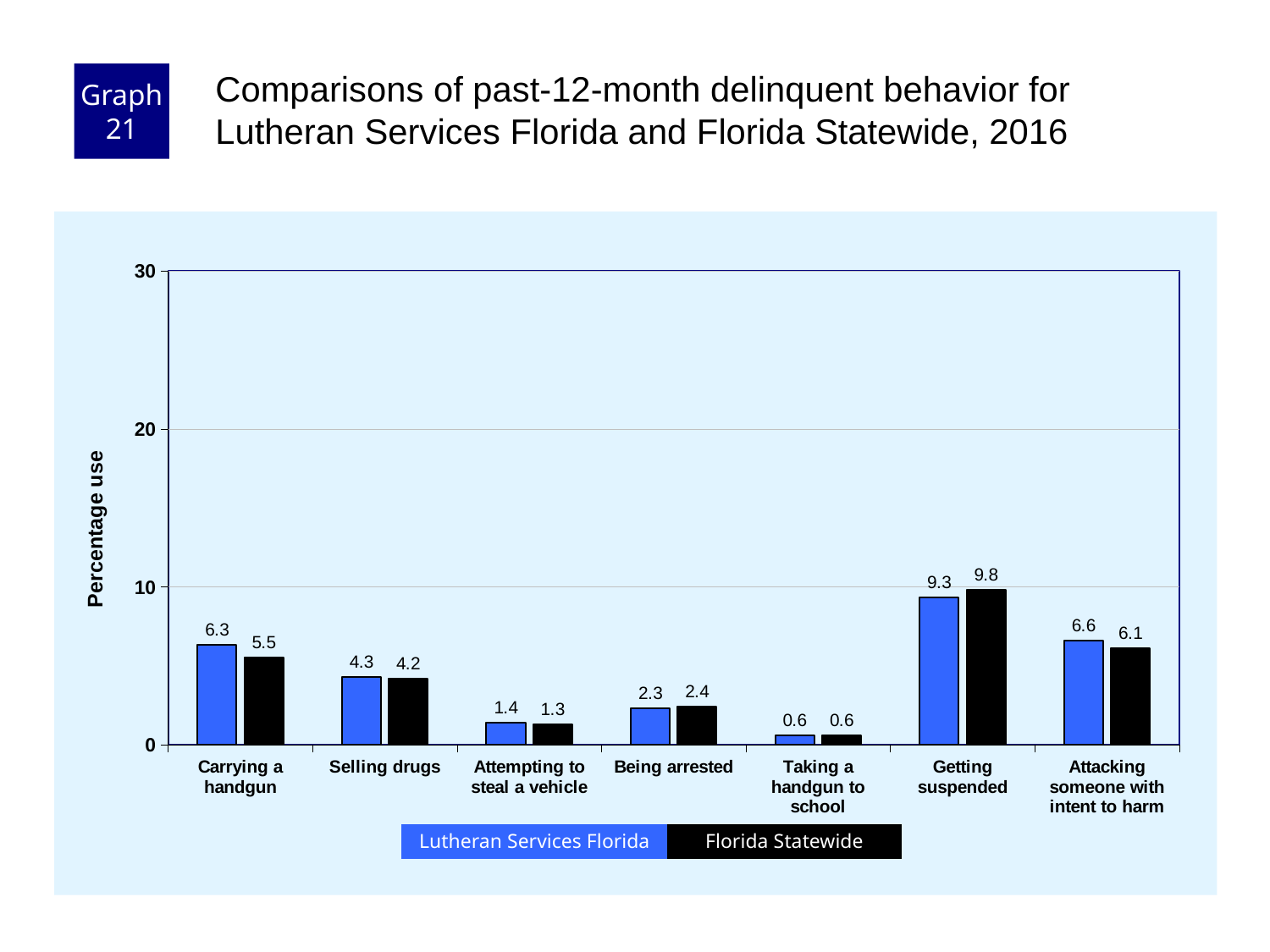
Is the Florida Statewide value for Getting suspended greater or less than 10? less Which category has the lowest Lutheran Services Florida value? Taking a handgun to school What kind of chart is shown? bar chart What is the label of the y axis? Percentage use For Attacking someone with intent to harm, which is larger: Lutheran Services Florida or Florida Statewide? Lutheran Services Florida What is the Florida Statewide value for Carrying a handgun? 5.5 What is the Lutheran Services Florida value for Attempting to steal a vehicle? 1.4 What is the Lutheran Services Florida value for Getting suspended? 9.3 How many categories are shown on the x axis? 7 How many series does the legend list? 2 Which category has the highest Florida Statewide value? Getting suspended What is the difference between the Lutheran Services Florida and Florida Statewide values for Carrying a handgun? 0.8